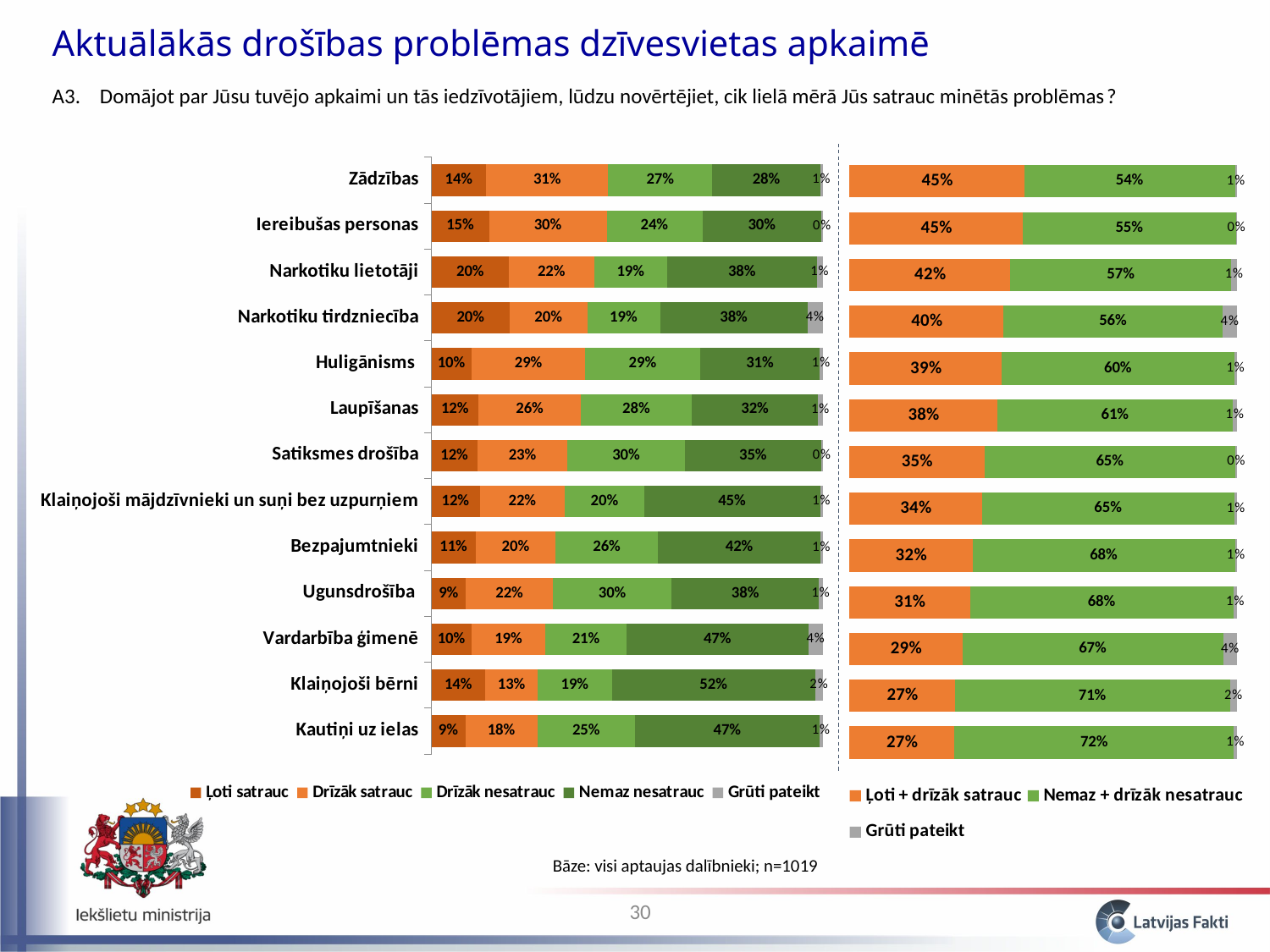
In the left chart, which is larger: the "Drīzāk satrauc" value for Zādzības or for Ugunsdrošība? Zādzības How many series does the legend of the left chart list? 5 In the right chart, what is the "Grūti pateikt" value for Narkotiku tirdzniecība? 4% In the right chart, which category has the lowest "Ļoti + drīzāk satrauc" value? Kautiņi uz ielas and Klaiņojoši bērni (both 27%) In the right chart, what is the "Ļoti + drīzāk satrauc" value for Zādzības? 45% What type of chart is the right chart? Stacked bar chart In the left chart, what is the "Ļoti satrauc" value for Narkotiku lietotāji? 20% In the right chart, which category has the highest "Nemaz + drīzāk nesatrauc" value? Kautiņi uz ielas How many categories are shown in the left chart? 13 In the left chart, what is the "Nemaz nesatrauc" value for Klaiņojoši bērni? 52% How many series does the legend of the right chart list? 3 In the left chart, what is the difference between the "Nemaz nesatrauc" values for Vardarbība ģimenē and Zādzības? 19%